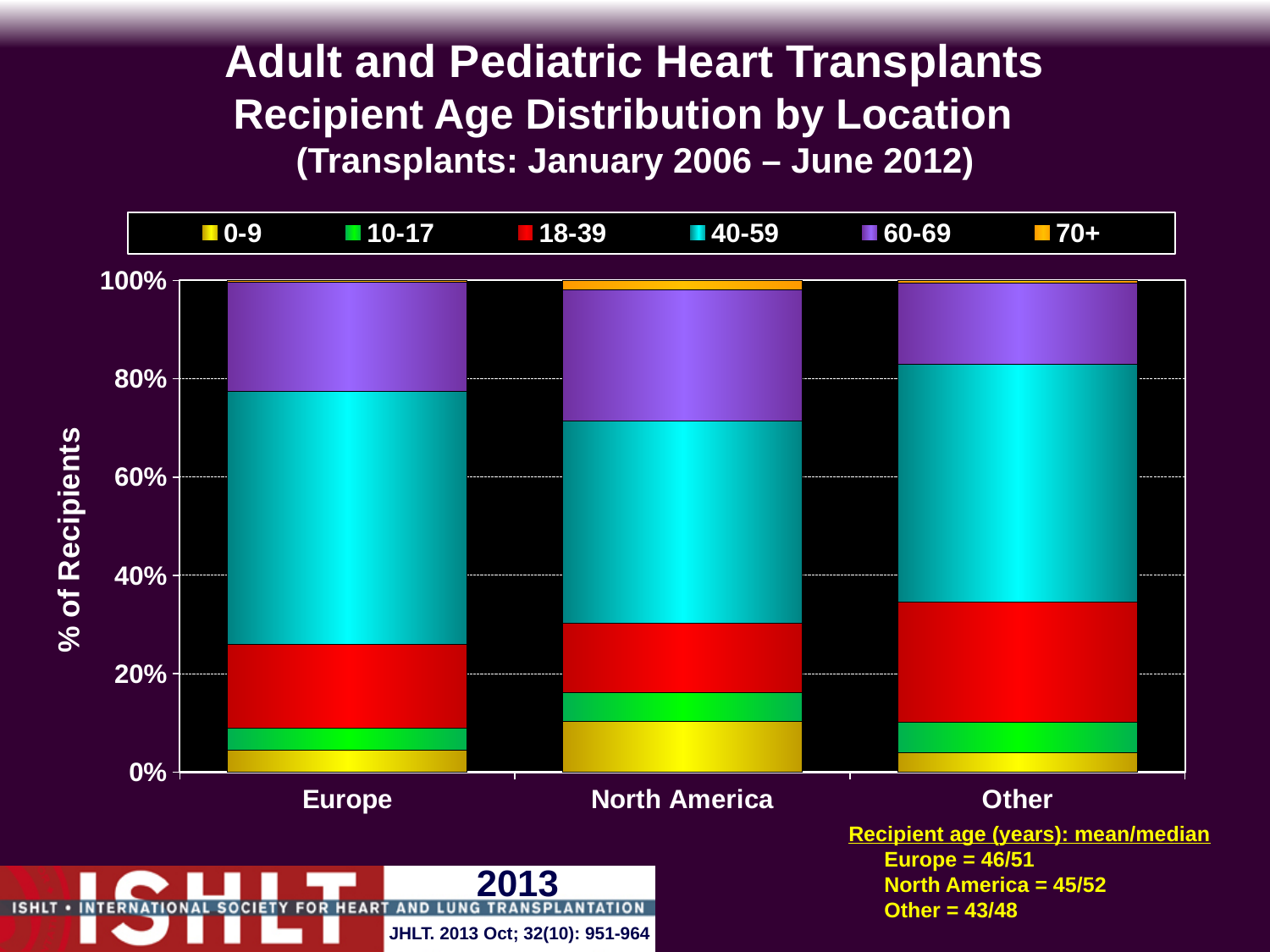
What kind of chart is shown on the slide? Stacked bar chart Is the 0-9 share for North America greater or less than 20%? less Which location has the largest 0-9 age group share? North America Which location has the largest 70+ age group share? North America Which location has the largest 18-39 age group share? Other What is the label on the y axis? % of Recipients Which is larger: the 60-69 share for North America or for Other? North America How many locations (categories) are shown on the x axis? 3 Which location has the smallest 60-69 age group share? Other Is the 40-59 share for Other greater or less than 40%? greater How many age groups does the legend list? 6 Is the 40-59 share for Europe greater or less than 40%? greater